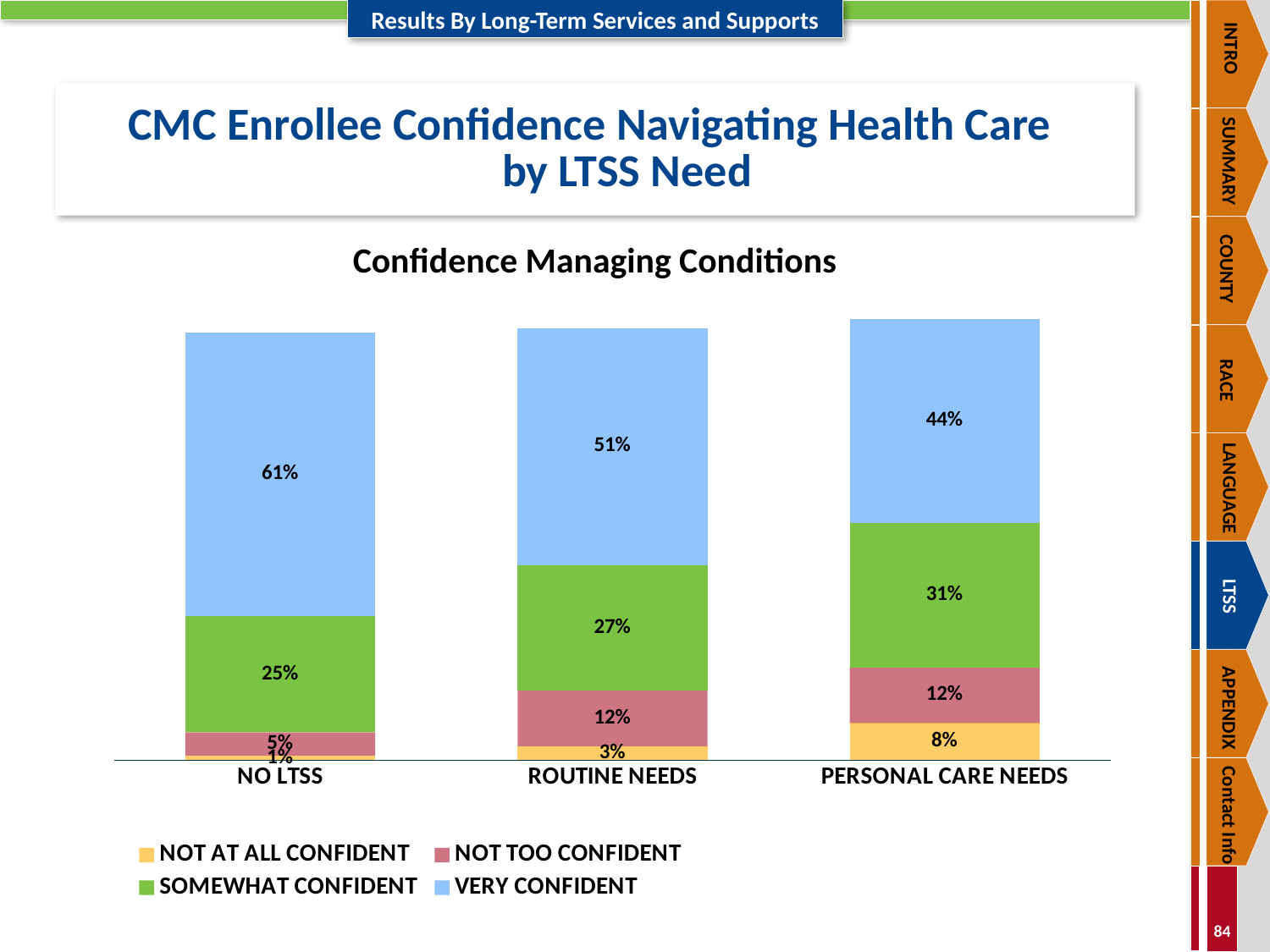
Which category has the highest VERY CONFIDENT value? NO LTSS How many categories are shown on the x axis? 3 What is the SOMEWHAT CONFIDENT value for PERSONAL CARE NEEDS? 31% What is the difference between the VERY CONFIDENT values for NO LTSS and PERSONAL CARE NEEDS? 17% What is the title of the chart? Confidence Managing Conditions Which category has the lowest NOT AT ALL CONFIDENT value? NO LTSS What is the NOT AT ALL CONFIDENT value for ROUTINE NEEDS? 3% What is the total of the four labelled segments in the ROUTINE NEEDS bar? 93% What kind of chart is shown on the slide? Stacked bar chart Which is larger, the SOMEWHAT CONFIDENT value for ROUTINE NEEDS or for PERSONAL CARE NEEDS? PERSONAL CARE NEEDS What percentage of NO LTSS enrollees are VERY CONFIDENT? 61% How many series does the legend list? 4